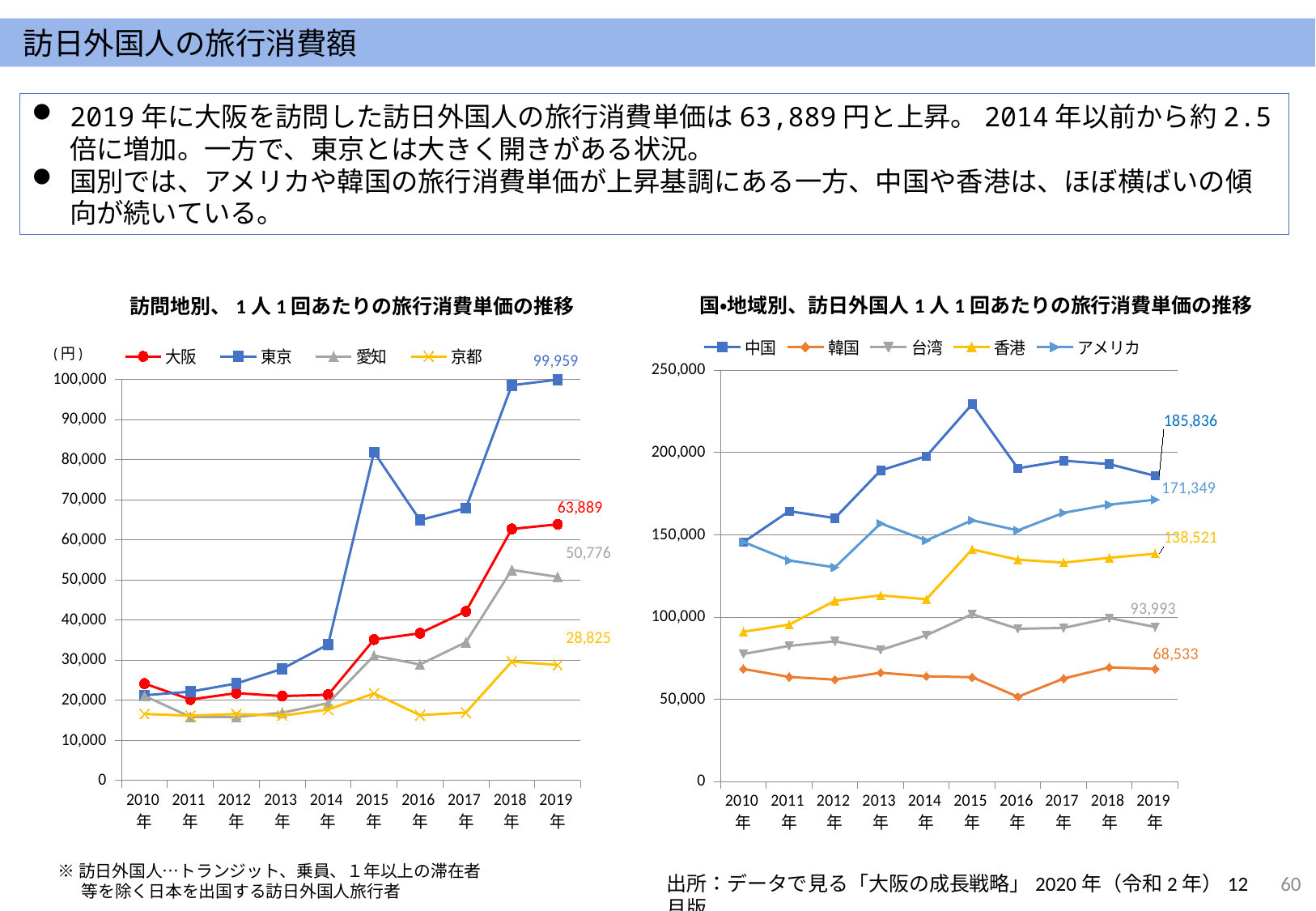
In the right chart (国・地域別、訪日外国人1人1回あたりの旅行消費単価の推移), how many years are shown on the x axis? 10 In the left chart (訪問地別、1人1回あたりの旅行消費単価の推移), is the value for 東京 in 2015年 greater or less than 80,000? greater In the right chart (国・地域別、訪日外国人1人1回あたりの旅行消費単価の推移), what is the value for 韓国 in 2019年? 68,533 In the left chart (訪問地別、1人1回あたりの旅行消費単価の推移), how many series does the legend list? 4 In the left chart (訪問地別、1人1回あたりの旅行消費単価の推移), what is the value for 東京 in 2019年? 99,959 What kind of chart is the right chart (国・地域別、訪日外国人1人1回あたりの旅行消費単価の推移)? line chart In the right chart (国・地域別、訪日外国人1人1回あたりの旅行消費単価の推移), what is the difference between the 2019年 values for アメリカ and 香港? 32,828 In the left chart (訪問地別、1人1回あたりの旅行消費単価の推移), what is the value for 大阪 in 2019年? 63,889 In the left chart (訪問地別、1人1回あたりの旅行消費単価の推移), what is the difference between the 2019年 values for 東京 and 大阪? 36,070 In the right chart (国・地域別、訪日外国人1人1回あたりの旅行消費単価の推移), what is the value for 中国 in 2019年? 185,836 In the left chart (訪問地別、1人1回あたりの旅行消費単価の推移), which series has the lowest value in 2019年? 京都 In the right chart (国・地域別、訪日外国人1人1回あたりの旅行消費単価の推移), which series has the highest value in 2019年? 中国